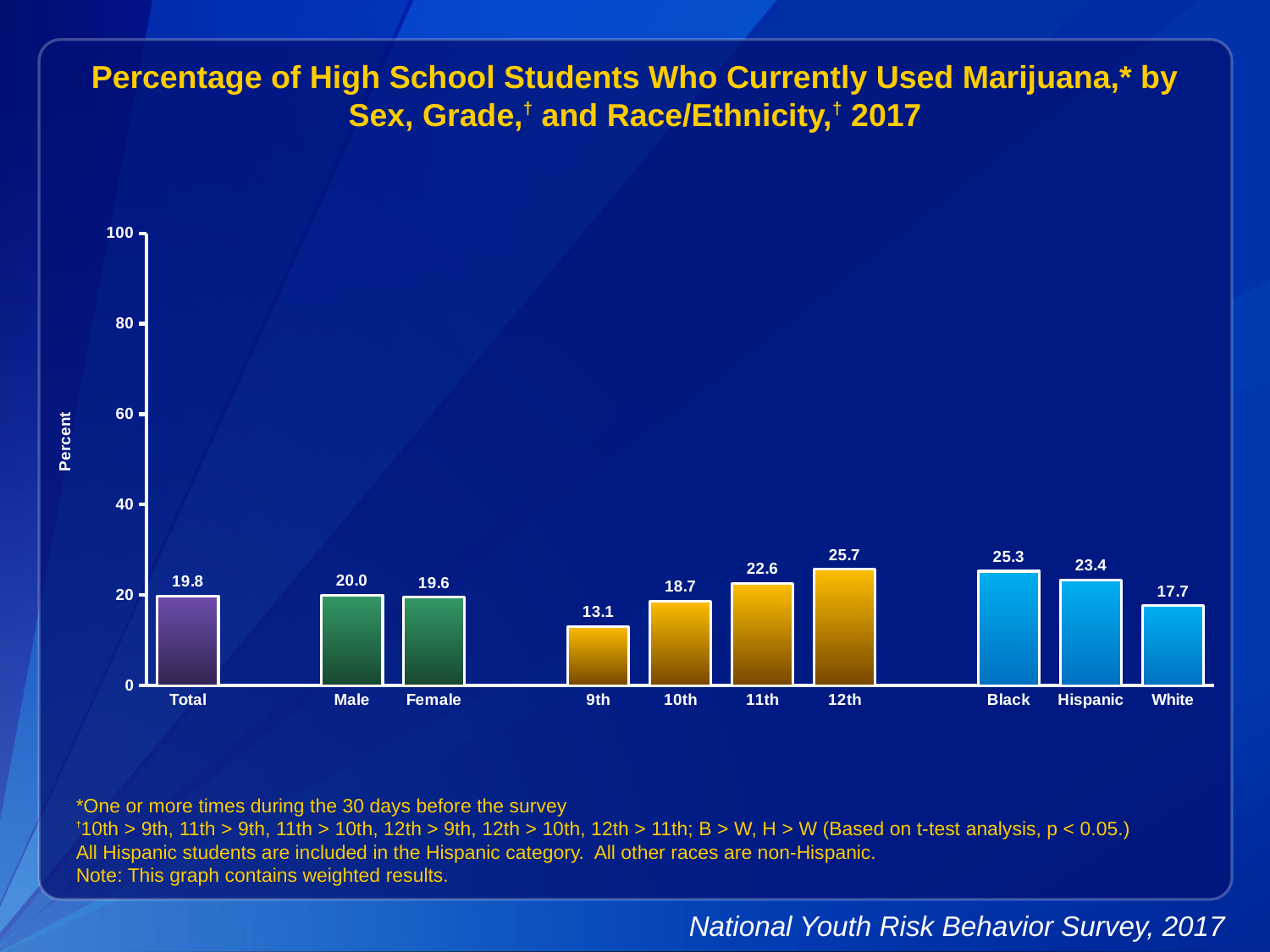
What kind of chart is shown on the slide? bar chart Do the values rise or fall from 9th grade to 12th grade? rise What is the difference between the values for Black and White students? 7.6 What is the value for Hispanic students? 23.4 What is the difference between the values for 12th and 9th grade? 12.6 What is the value for 9th grade students? 13.1 What is the value for Total? 19.8 Is the value for 11th grade greater or less than 20? greater How many categories are shown on the x axis? 10 Which category has the highest value? 12th Which category has the lowest value? 9th Which is larger, the value for Male or the value for Female? Male